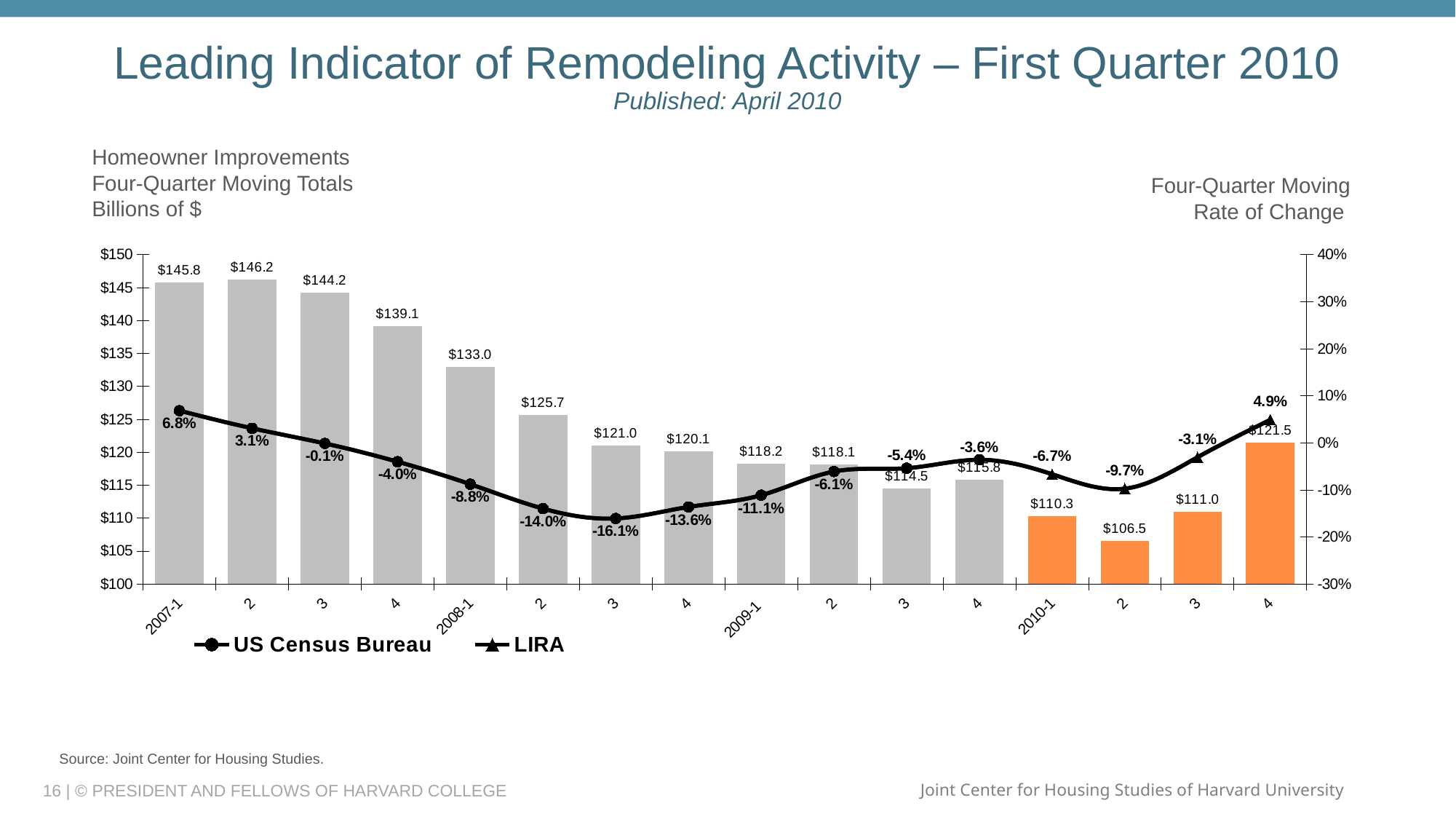
How many quarterly bars are plotted in the chart? 16 What is the difference between the four-quarter moving totals for 2007-1 and 2010-4? $24.3 Do the four-quarter moving total bars rise or fall from 2007-1 to 2010-2? Fall What kind of chart is shown on the slide? Combination bar and line chart What is the LIRA rate of change shown for the fourth quarter of 2010? 4.9% Which two series are named in the legend? US Census Bureau and LIRA Which has the larger four-quarter moving total, 2009-3 or 2009-4? 2009-4 How many series does the legend list? 2 What is the four-quarter moving rate of change shown for the third quarter of 2008? -16.1% What is the four-quarter moving total of homeowner improvements for 2008-1? $133.0 Which quarter has the highest four-quarter moving total bar? 2007-2 ($146.2) Which quarter has the lowest four-quarter moving total bar? 2010-2 ($106.5)